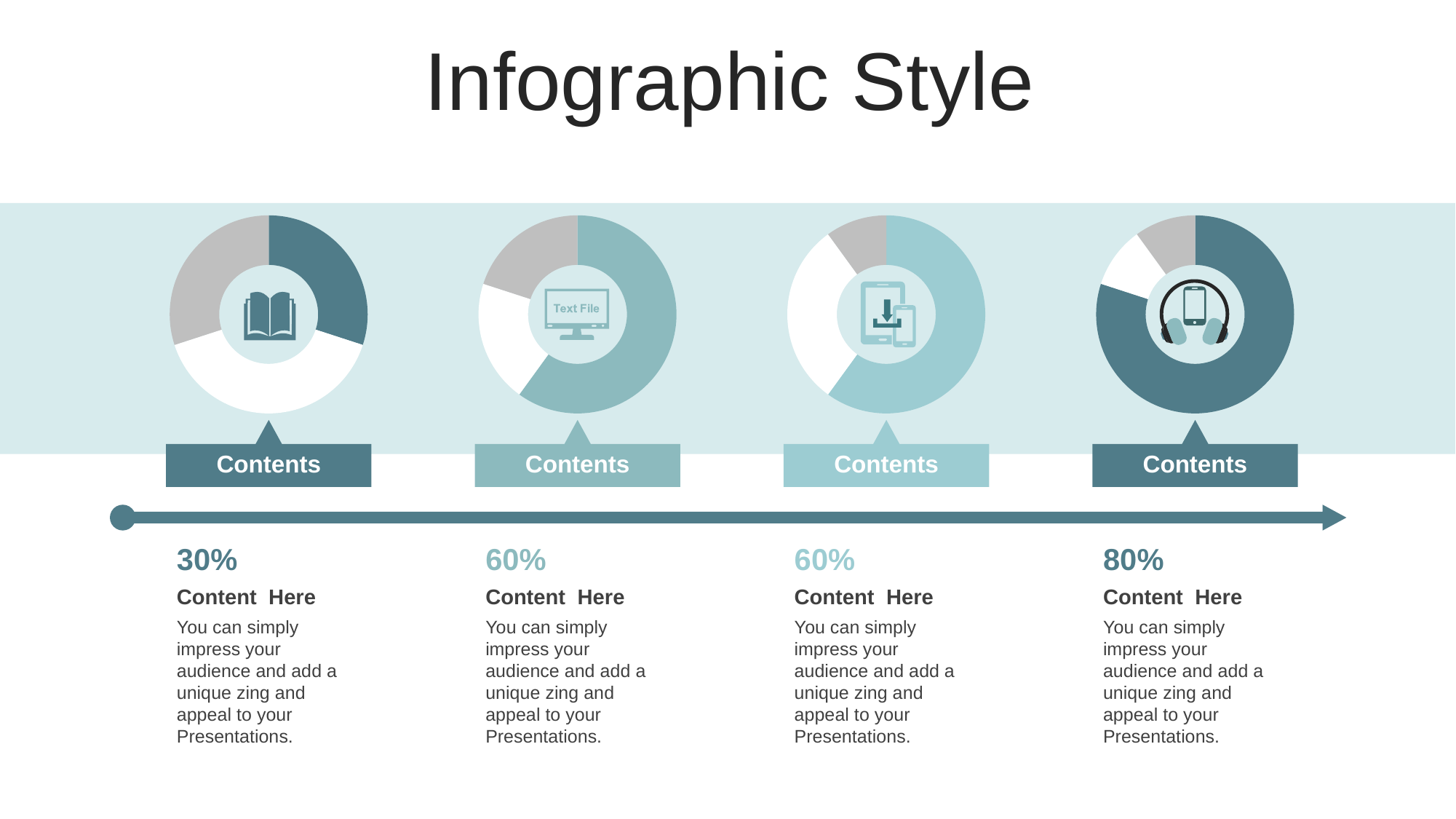
How many donut charts are shown on the slide? 4 What percentage is shown for the rightmost chart (the one with the headphones icon)? 80% What percentage is shown for the second chart from the left (the one with the Text File monitor icon)? 60% What label appears in the box beneath each donut chart? Contents What kind of charts are shown in the row across the slide? Donut (pie) charts Which chart has the lowest percentage value? The leftmost chart (book icon), 30% What percentage is shown for the leftmost chart (the one with the book icon)? 30% Do the percentage values rise or fall from left to right across the slide? Rise Which is larger, the percentage for the leftmost chart or the percentage for the second chart from the left? The second chart from the left (60%) Which chart has the highest percentage value? The rightmost chart (headphones icon), 80% What is the difference between the percentage of the rightmost chart and the leftmost chart? 50% What percentage is shown for the third chart from the left (the one with the download/devices icon)? 60%